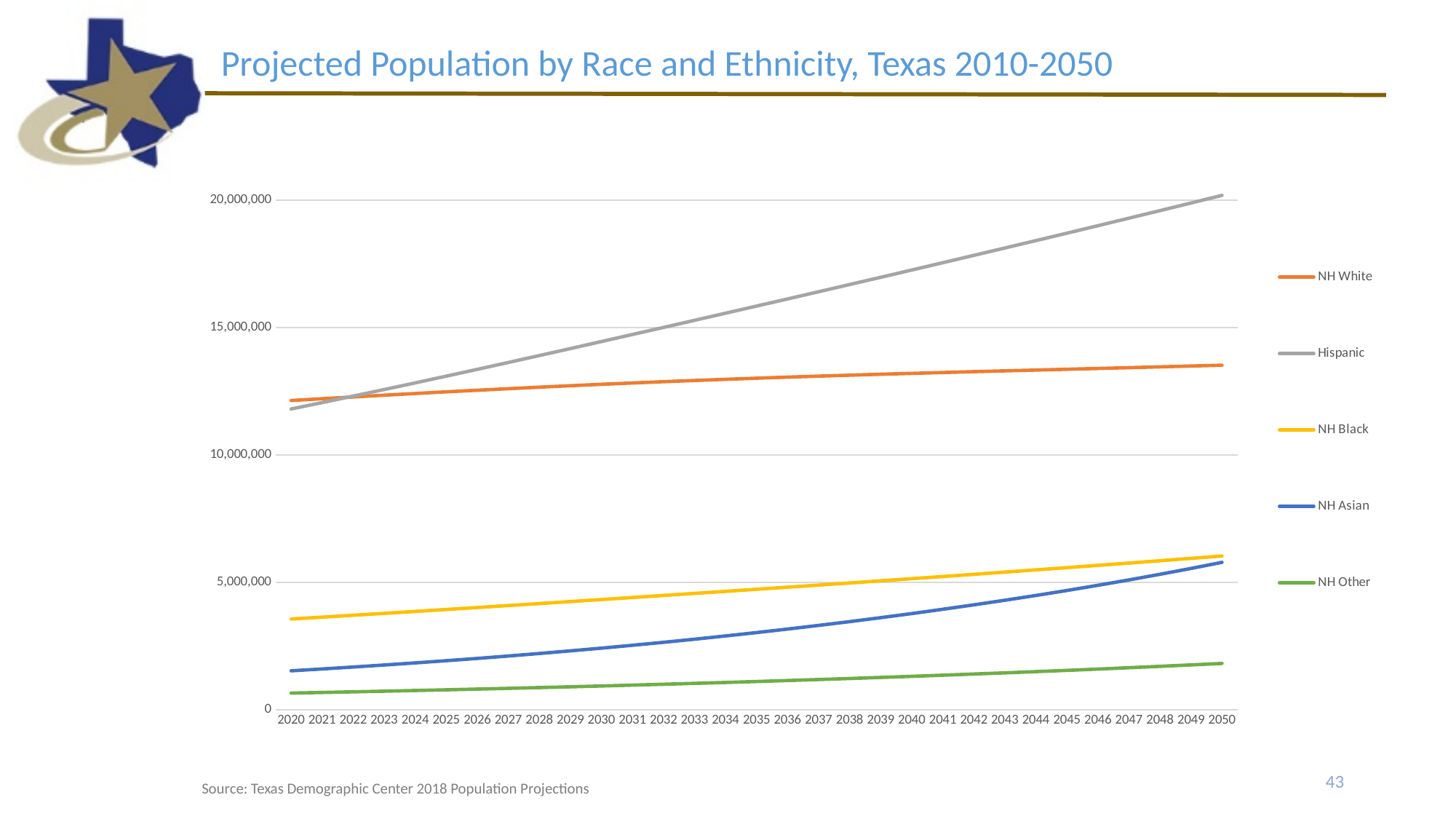
What kind of chart is shown on the slide? Line chart Is the NH Black value for 2020 greater or less than 5,000,000? less How many series does the legend list? 5 What is the title of the chart? Projected Population by Race and Ethnicity, Texas 2010-2050 Which group has the highest projected population in 2050? Hispanic Is the Hispanic value for 2050 greater or less than 15,000,000? greater Does the Hispanic population rise or fall from 2020 to 2050? Rise How many years are shown along the x axis? 31 Is the NH Asian value for 2050 greater or less than 5,000,000? greater In 2020, which is larger: NH Black or NH Asian? NH Black Which group has the lowest projected population across the whole period? NH Other